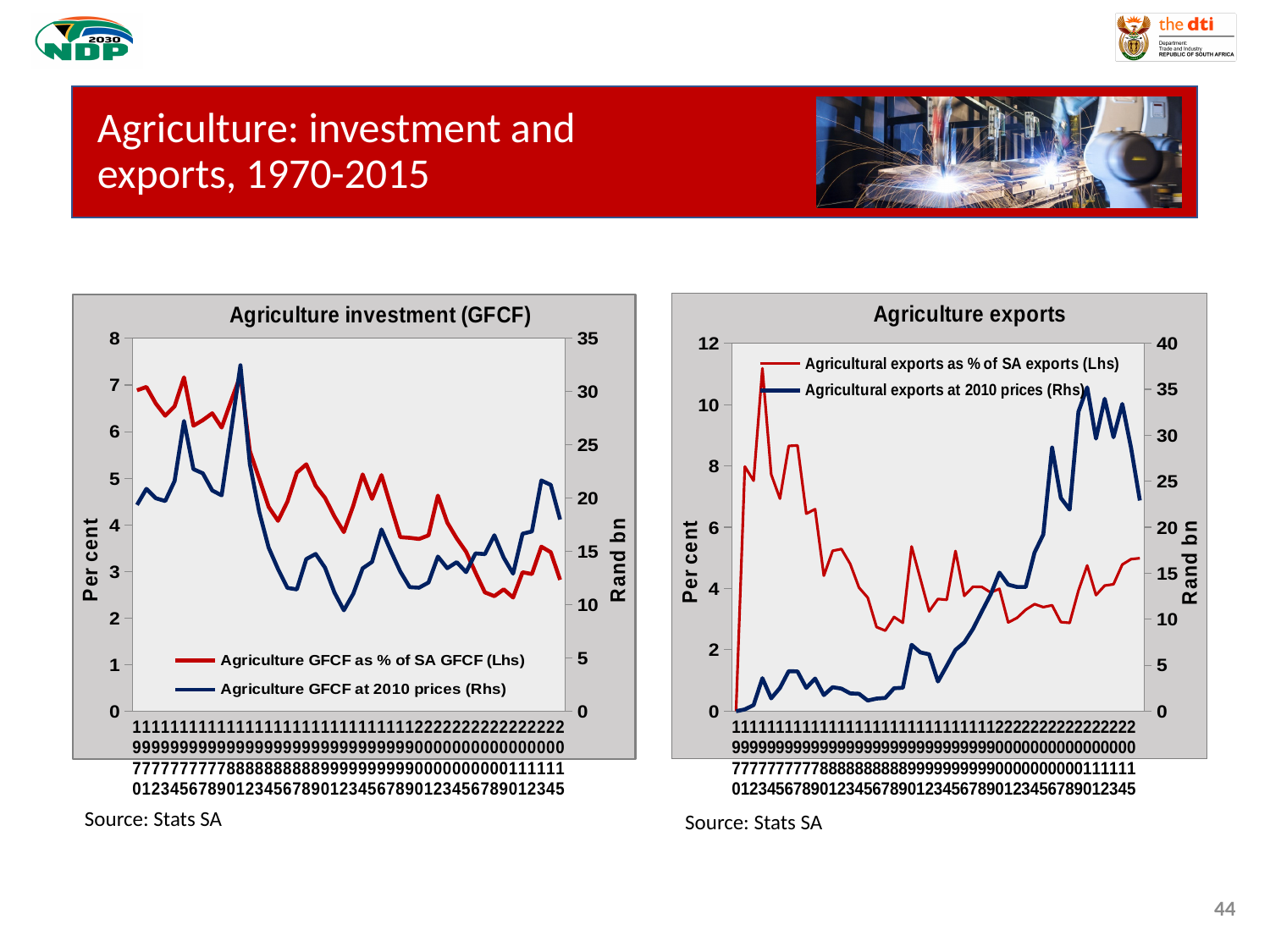
In the 'Agriculture exports' chart, is the value of 'Agricultural exports at 2010 prices (Rhs)' in 2015 greater or less than 20? greater What kind of chart is the 'Agriculture exports' chart? Line chart In the 'Agriculture investment (GFCF)' chart, what is the title of the right-hand vertical axis? Rand bn In the 'Agriculture exports' chart, does the 'Agricultural exports at 2010 prices (Rhs)' series generally rise or fall from 1970 to 2015? Rise In the 'Agriculture exports' chart, which series is plotted in red? Agricultural exports as % of SA exports (Lhs) In the 'Agriculture investment (GFCF)' chart, does the 'Agriculture GFCF as % of SA GFCF (Lhs)' series generally rise or fall from 1970 to 2015? Fall How many series does the legend of the 'Agriculture investment (GFCF)' chart list? 2 In the 'Agriculture investment (GFCF)' chart, is the value of 'Agriculture GFCF as % of SA GFCF (Lhs)' in 2015 greater or less than 4? less In the 'Agriculture investment (GFCF)' chart, is the value of 'Agriculture GFCF as % of SA GFCF (Lhs)' in 1970 greater or less than 6? greater How many series does the legend of the 'Agriculture exports' chart list? 2 How many years are plotted along the x axis of the 'Agriculture exports' chart? 46 What kind of chart is the 'Agriculture investment (GFCF)' chart? Line chart